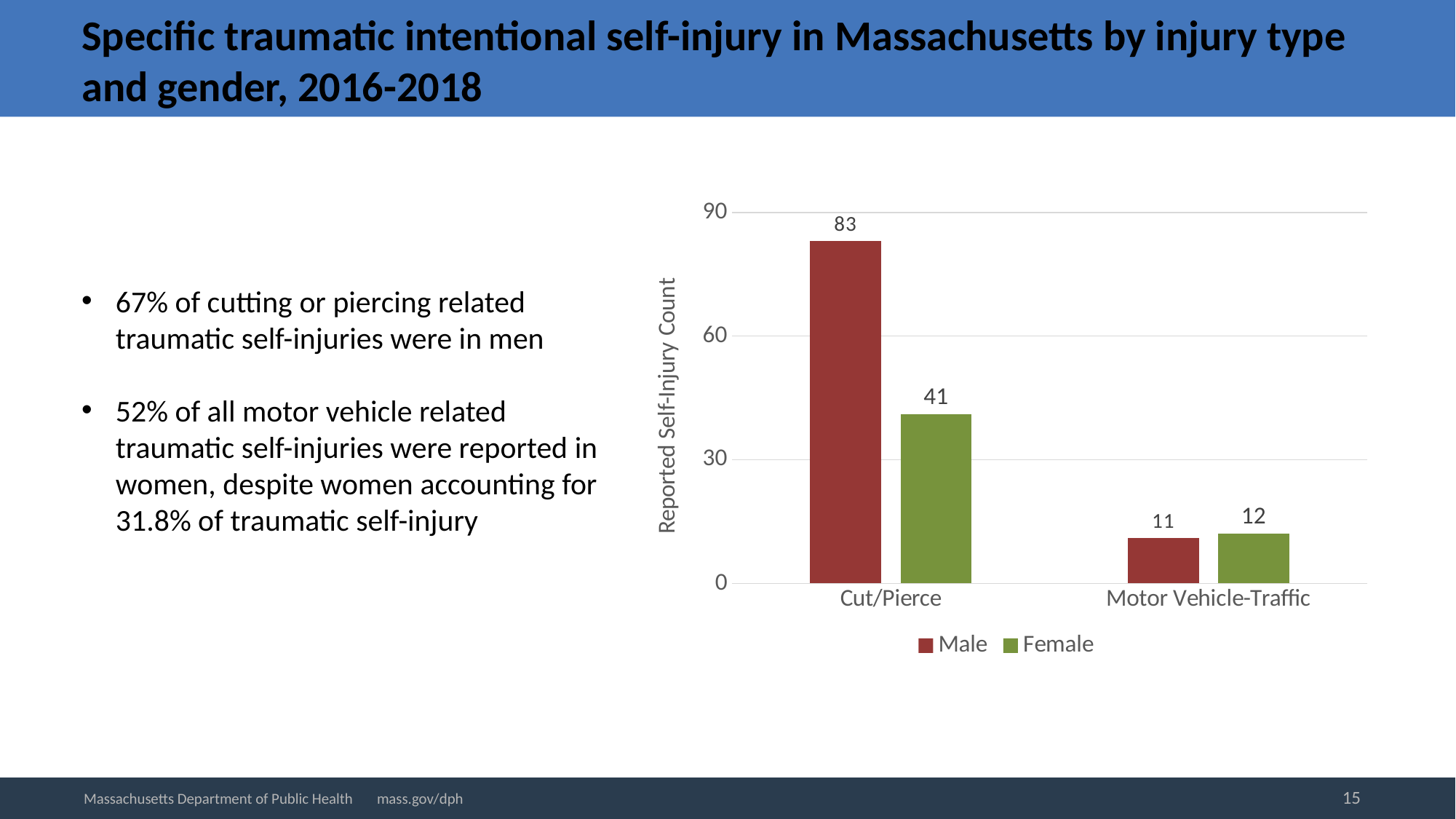
Is the Female value for Cut/Pierce greater or less than 30? greater What is the Male value for Cut/Pierce? 83 Which injury type has the highest Male count? Cut/Pierce Which is larger for Cut/Pierce, the Male value or the Female value? Male What is the Female value for Cut/Pierce? 41 Which injury type has the lowest Female count? Motor Vehicle-Traffic What is the Male value for Motor Vehicle-Traffic? 11 What is the Female value for Motor Vehicle-Traffic? 12 How many injury type categories are shown on the x axis? 2 What kind of chart is shown on the slide? Bar chart How many series does the legend list? 2 What is the difference between the Male and Female values for Cut/Pierce? 42